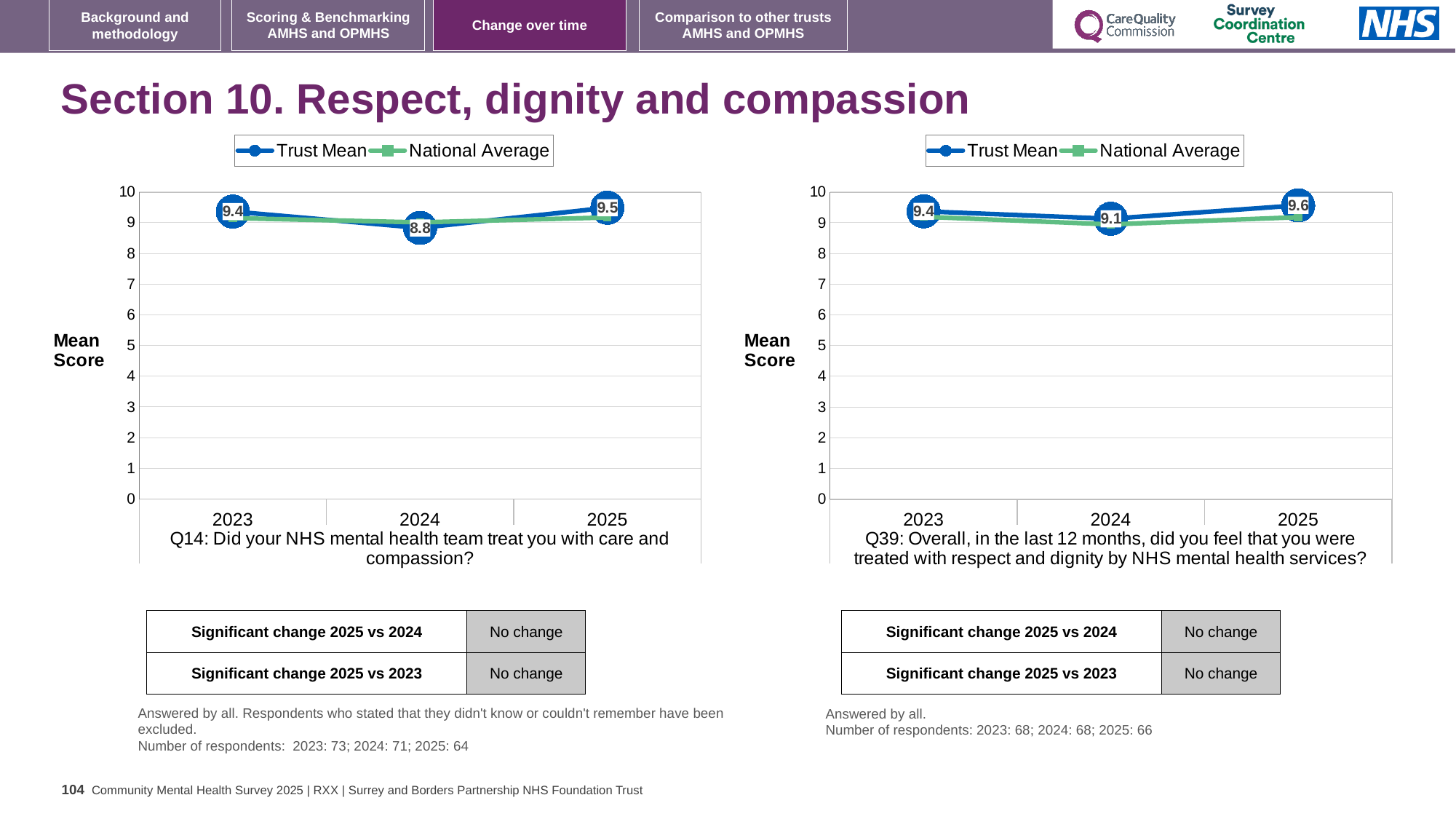
In the Q39 chart on the right, what is the Trust Mean for 2023? 9.4 In the Q14 chart on the left, which year has the lowest Trust Mean? 2024 What type of chart is the Q39 chart on the right? Line chart How many series does the legend of the Q14 chart on the left list? 2 In the Q14 chart on the left, what is the Trust Mean for 2024? 8.8 How many years are plotted on the x axis of the Q39 chart on the right? 3 In the Q14 chart on the left, what is the difference between the Trust Mean for 2025 and 2024? 0.7 In the Q39 chart on the right, what is the Trust Mean for 2025? 9.6 In the Q39 chart on the right, is the Trust Mean for 2025 larger or smaller than the Trust Mean for 2024? larger In the Q14 chart on the left, is the National Average for 2024 greater or less than 8? greater In the Q39 chart on the right, which year has the highest Trust Mean? 2025 In the Q14 chart on the left, what is the Trust Mean for 2025? 9.5